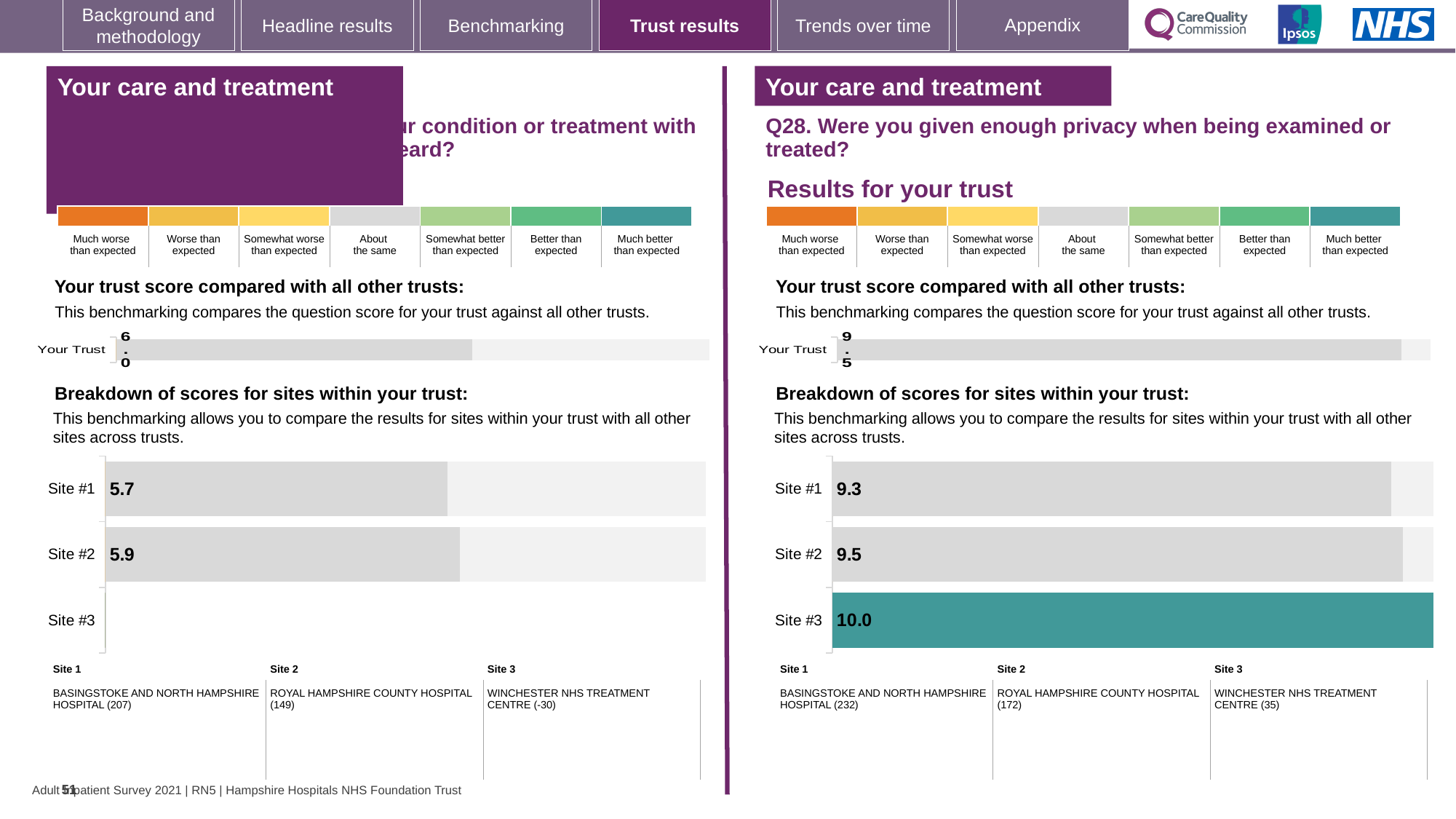
On the left-hand site breakdown chart, which is larger, the score for Site #1 or Site #2? Site #2 On the right-hand chart (Q28), which site has the highest score? Site #3 On the right-hand panel (Q28), what is the 'Your Trust' score compared with all other trusts? 9.5 On the right-hand chart (Q28), what is the score for Site #2? 9.5 On the left-hand panel, what is the 'Your Trust' score compared with all other trusts? 6.0 On the left-hand site breakdown chart, what is the score for Site #1? 5.7 On the left-hand site breakdown chart, what is the score for Site #2? 5.9 On the right-hand chart (Q28), what is the score for Site #1? 9.3 On the right-hand chart (Q28, privacy when being examined or treated), what is the score for Site #3? 10.0 On the right-hand chart (Q28), which site has the lowest score? Site #1 What type of chart is used for the breakdown of scores for sites within your trust? Bar chart On the right-hand chart (Q28), what is the difference between the scores for Site #3 and Site #1? 0.7